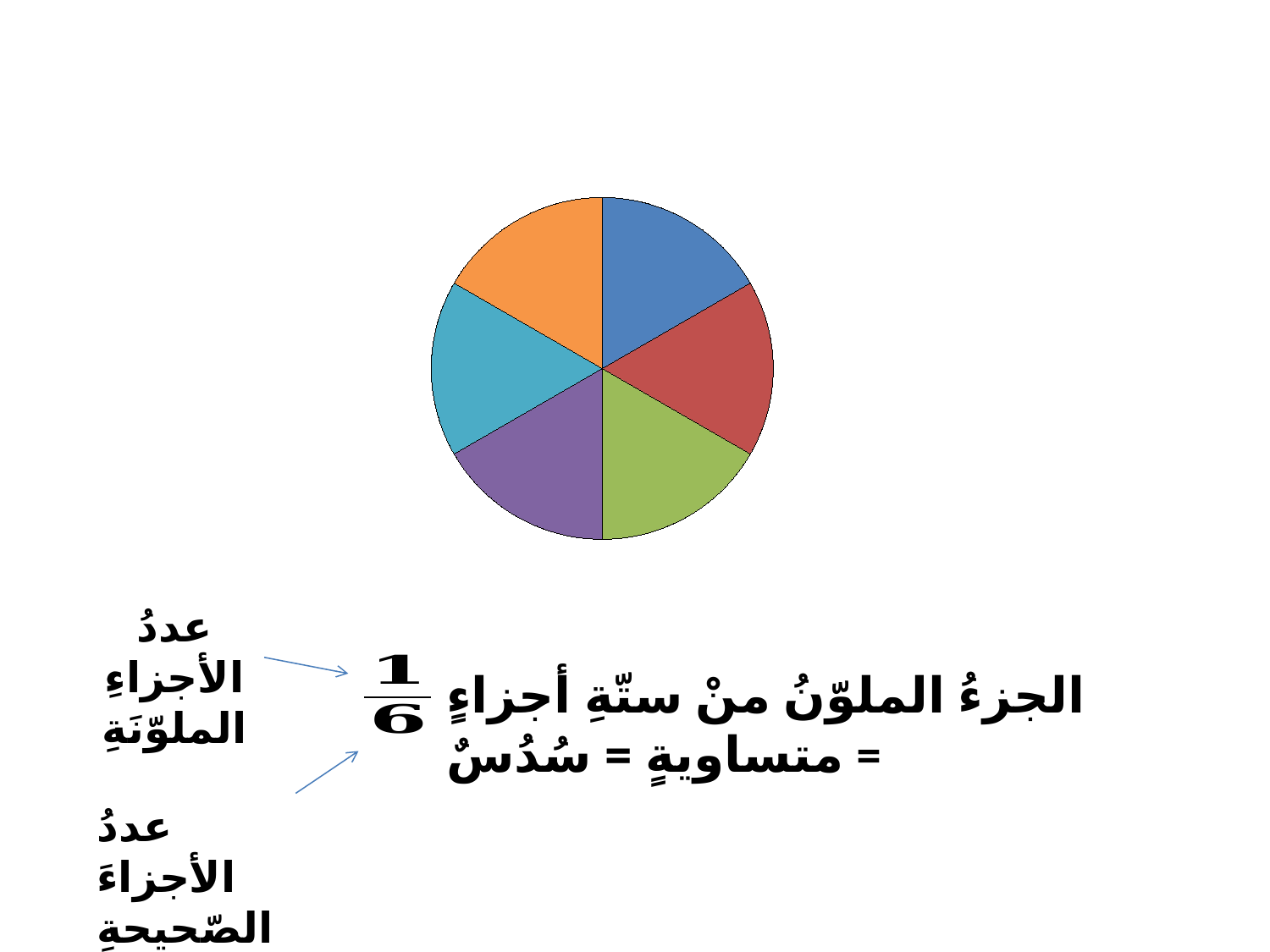
What kind of chart is shown on the slide? pie chart Are the slices of the pie chart equal in size or different in size? equal Does the pie chart have a legend? No How many slices does the pie chart have? 6 How many different colours are used for the slices of the pie chart? 6 What fraction of the whole pie does one slice represent, as written on the slide? 1/6